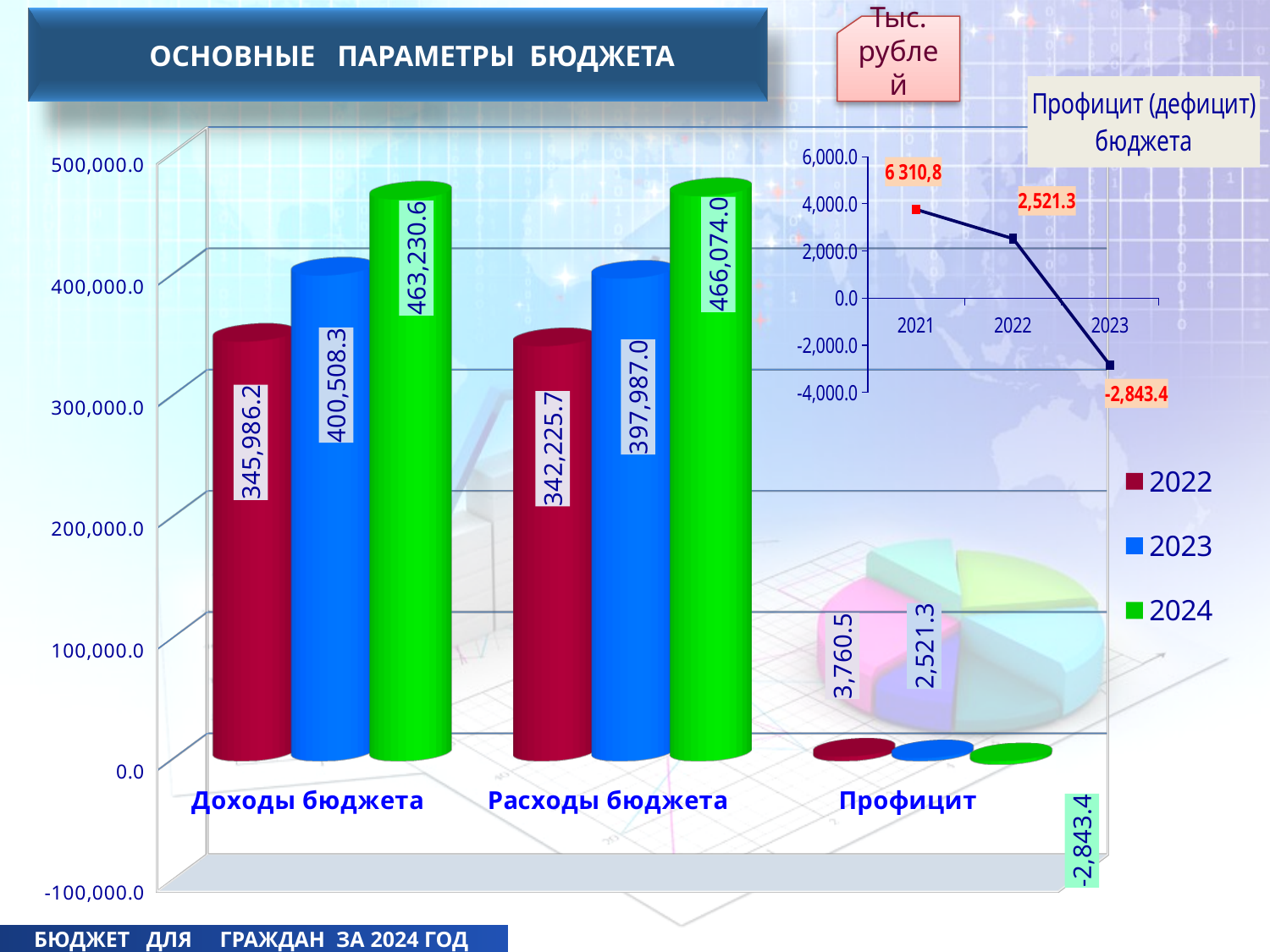
In the bar chart, which year has the lowest value for Доходы бюджета? 2022 In the line chart Профицит (дефицит) бюджета, do the values rise or fall from 2021 to 2023? fall How many series does the legend of the bar chart list? 3 In the bar chart, what is the value for Доходы бюджета in 2024? 463,230.6 In the bar chart, what is the difference between Доходы бюджета in 2024 and in 2022? 117,244.4 In the bar chart, which is larger in 2024: Доходы бюджета or Расходы бюджета? Расходы бюджета In the line chart Профицит (дефицит) бюджета, how many years are plotted? 3 In the bar chart, which year has the highest value for Расходы бюджета? 2024 In the bar chart, what is the value for Расходы бюджета in 2023? 397,987.0 In the bar chart, what is the value for Профицит in 2024? -2,843.4 In the bar chart, what is the difference between Доходы бюджета and Расходы бюджета in 2022? 3,760.5 In the line chart Профицит (дефицит) бюджета, what is the value for 2023? -2,843.4